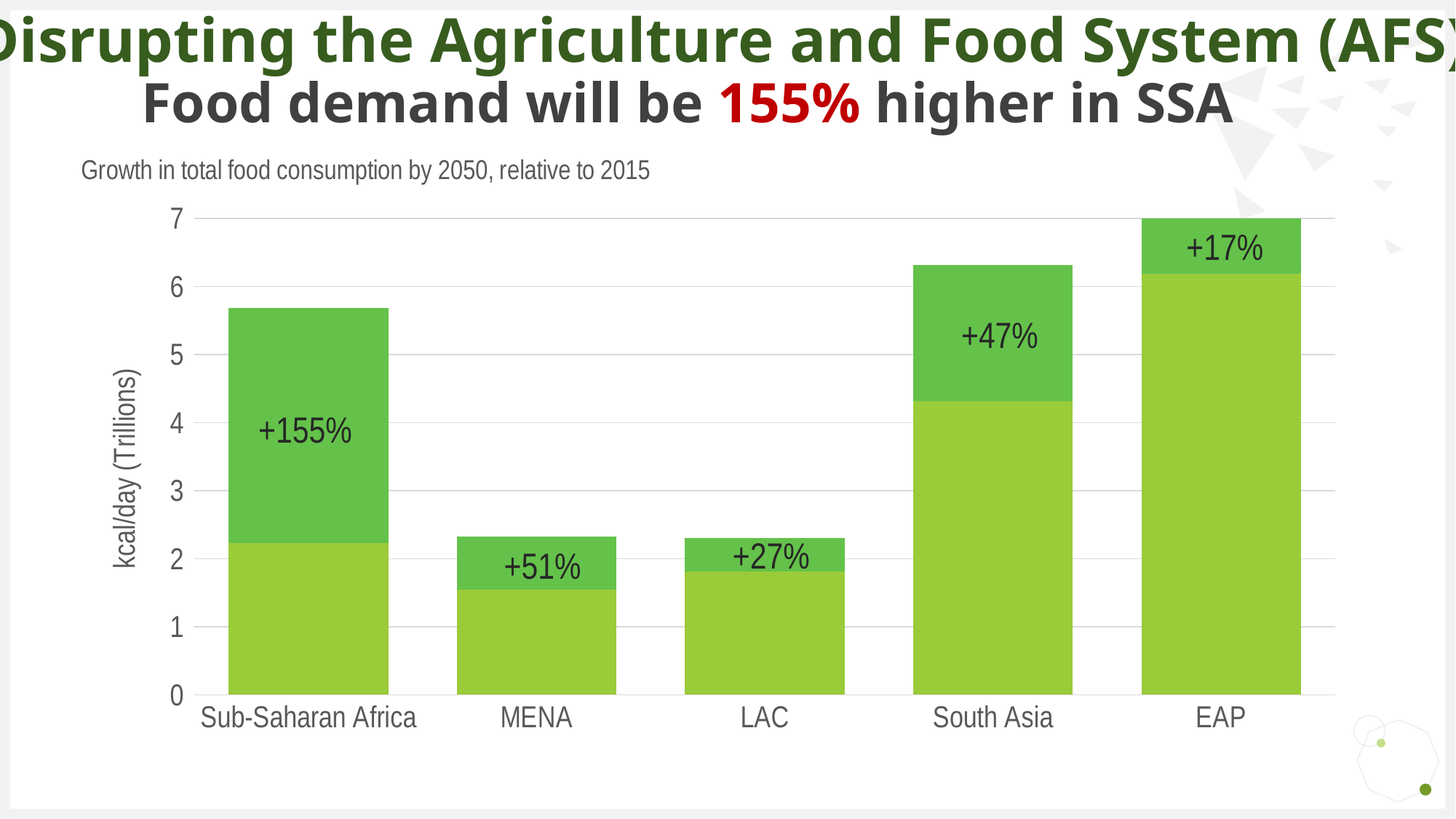
What is the label on the vertical axis? kcal/day (Trillions) What growth percentage is shown for South Asia? +47% Which total bar is taller, South Asia or Sub-Saharan Africa? South Asia What growth percentage is shown for EAP? +17% Is the total bar for Sub-Saharan Africa greater or less than 5 trillion kcal/day? greater Which region has the tallest total bar? EAP What growth percentage is shown for Sub-Saharan Africa? +155% Is the total bar for LAC greater or less than 3 trillion kcal/day? less What growth percentage is shown for LAC? +27% How many regions are shown on the x axis? 5 Which region has the highest growth percentage label? Sub-Saharan Africa Which region has the lowest growth percentage label? EAP